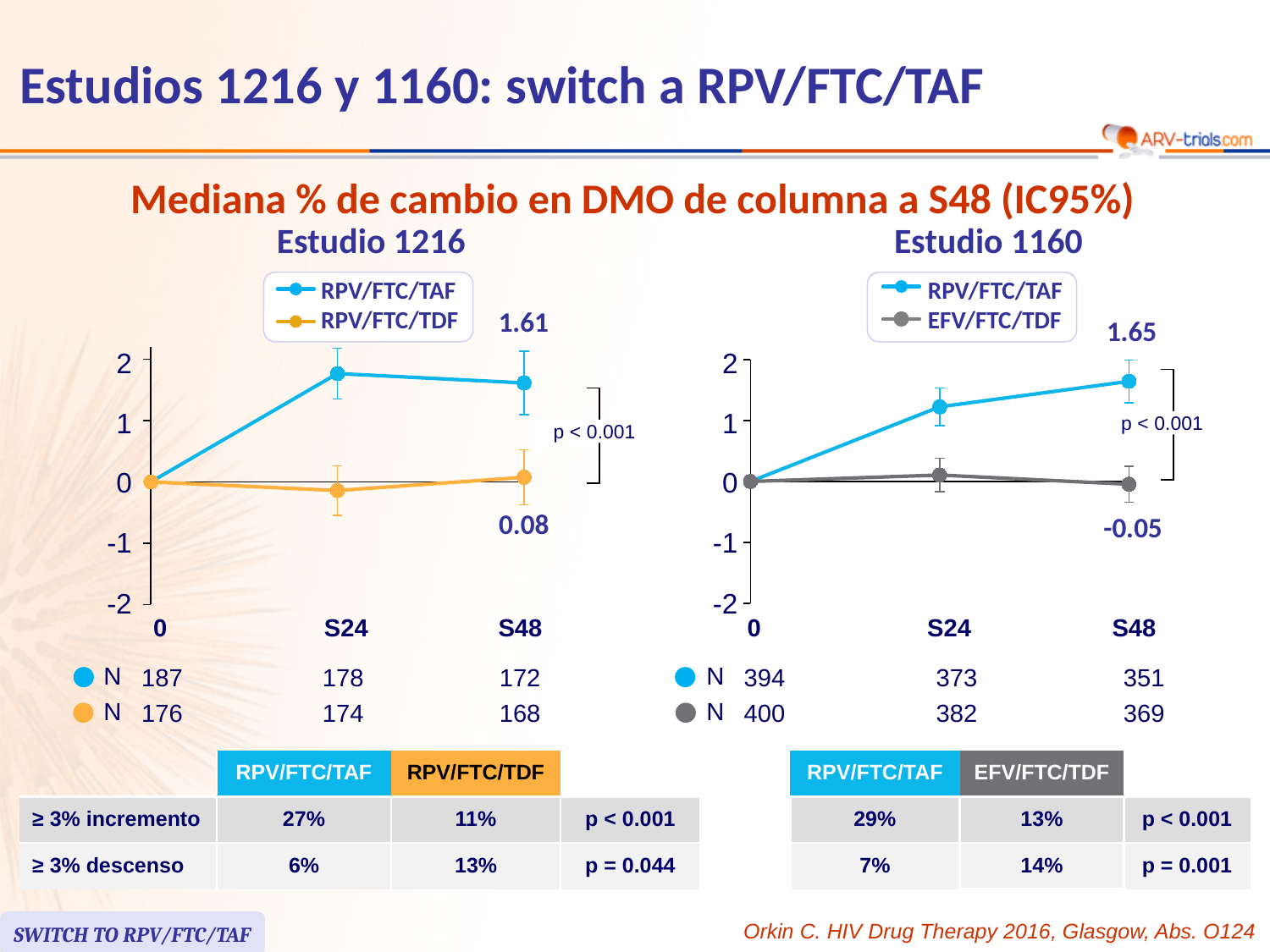
In the Estudio 1160 chart, what is the difference between the RPV/FTC/TAF and EFV/FTC/TDF values at S48? 1.70 In the Estudio 1160 chart, what is the value for EFV/FTC/TDF at S48? -0.05 What kind of chart is the Estudio 1216 chart? Line chart In the Estudio 1216 chart, is the value for RPV/FTC/TAF at S24 greater or less than 1? greater In the Estudio 1216 chart, what is the value for RPV/FTC/TDF at S48? 0.08 In the Estudio 1160 chart, what is the value for RPV/FTC/TAF at S48? 1.65 How many time points are plotted on the x axis of the Estudio 1160 chart? 3 How many series does the legend of the Estudio 1216 chart list? 2 In the Estudio 1160 chart, which series has the higher value at S48, RPV/FTC/TAF or EFV/FTC/TDF? RPV/FTC/TAF In the Estudio 1160 chart, does the RPV/FTC/TAF series rise or fall from 0 to S48? Rise In the Estudio 1216 chart, what is the value for RPV/FTC/TAF at S48? 1.61 In the Estudio 1216 chart, what is the difference between the RPV/FTC/TAF and RPV/FTC/TDF values at S48? 1.53